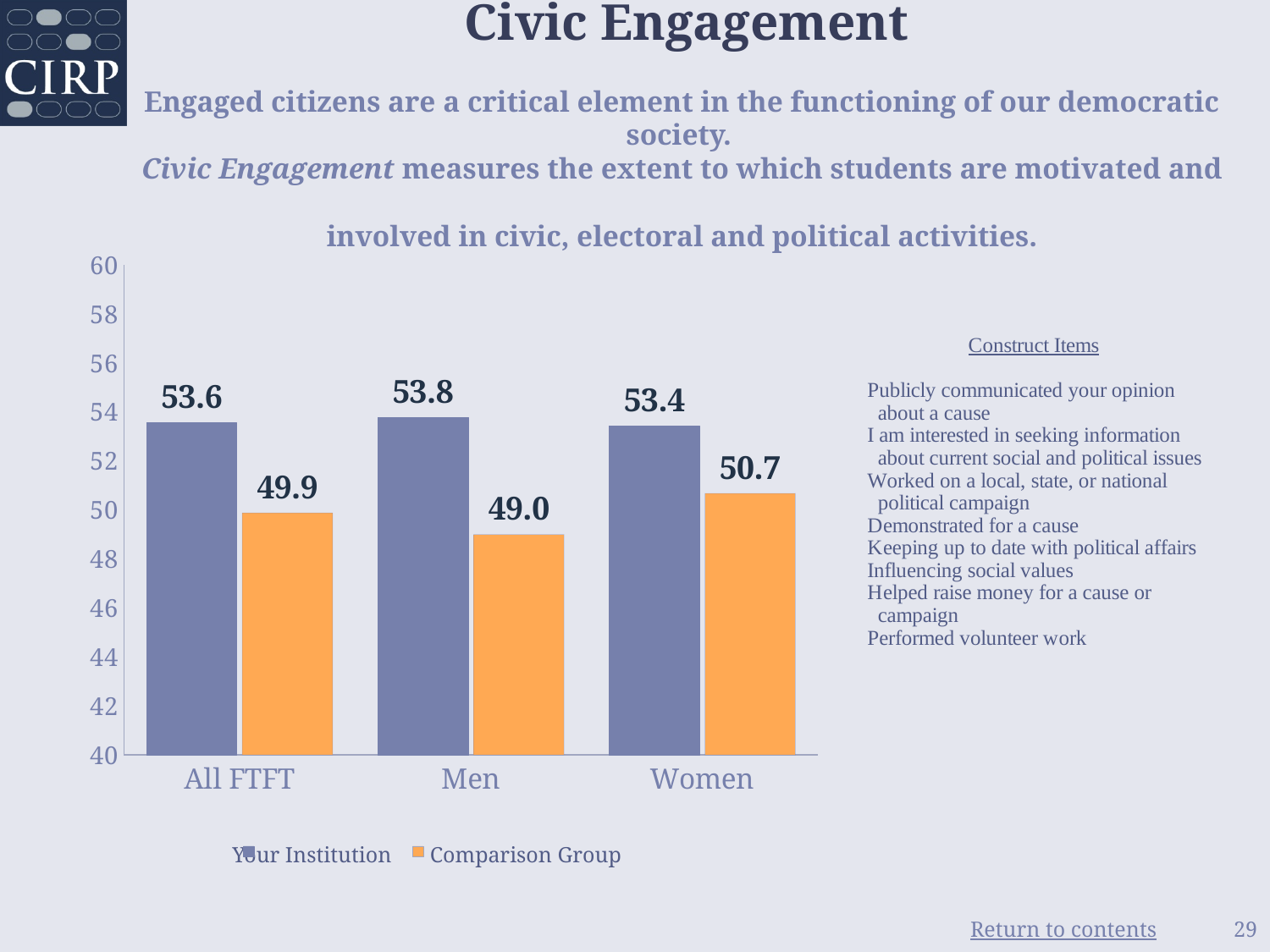
Which category has the lowest Comparison Group value? Men What colour are the Comparison Group bars? Orange Which is larger for All FTFT: Your Institution or Comparison Group? Your Institution What is the Comparison Group value for Women? 50.7 What is the Your Institution value for Men? 53.8 What kind of chart is shown on the slide? Bar chart What is the Comparison Group value for All FTFT? 49.9 How many series does the legend list? 2 What is the difference between the Your Institution and Comparison Group values for Women? 2.7 Which category has the highest Your Institution value? Men How many categories are shown on the x axis? 3 What is the difference between the Your Institution and Comparison Group values for Men? 4.8